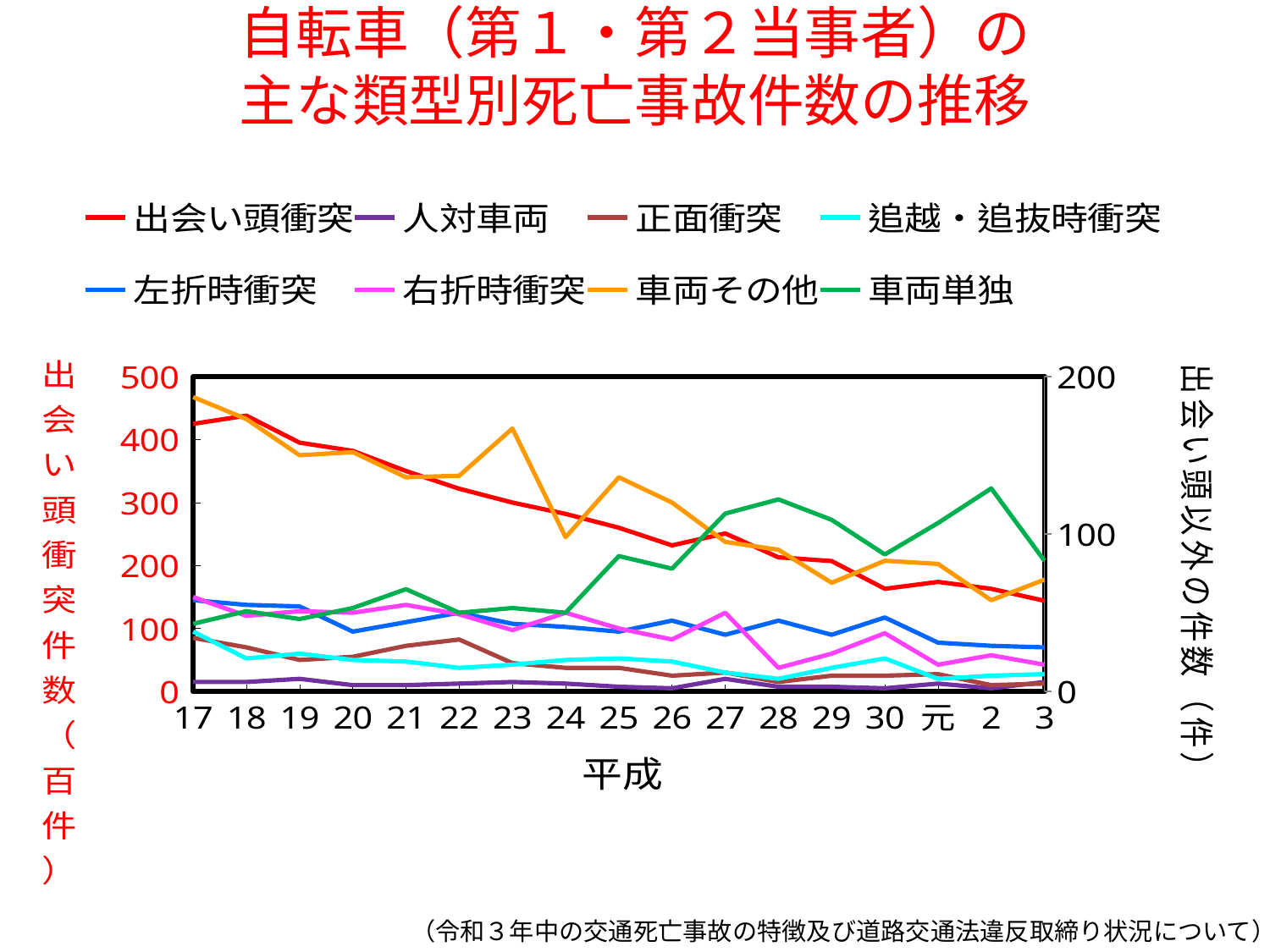
Which is larger for 車両単独: the value in 令和2 or the value in 令和3? 令和2 Is the value for 出会い頭衝突 in 令和3 greater or less than 200 on the left axis? less Is the value for 左折時衝突 in 平成17 greater or less than 100 on the right axis? less What is the title of the chart? 自転車（第１・第２当事者）の主な類型別死亡事故件数の推移 How many points are plotted along the x axis (from 平成17 to 令和3)? 17 Does the 出会い頭衝突 line generally rise or fall from 平成17 to 令和3? fall Is the value for 車両単独 in 令和2 greater or less than 100 on the right axis? greater Which is larger for 車両その他: the value in 平成17 or the value in 令和3? 平成17 What kind of chart is shown on the slide? line chart How many series does the legend list? 8 What colour is the 出会い頭衝突 line in the legend? red